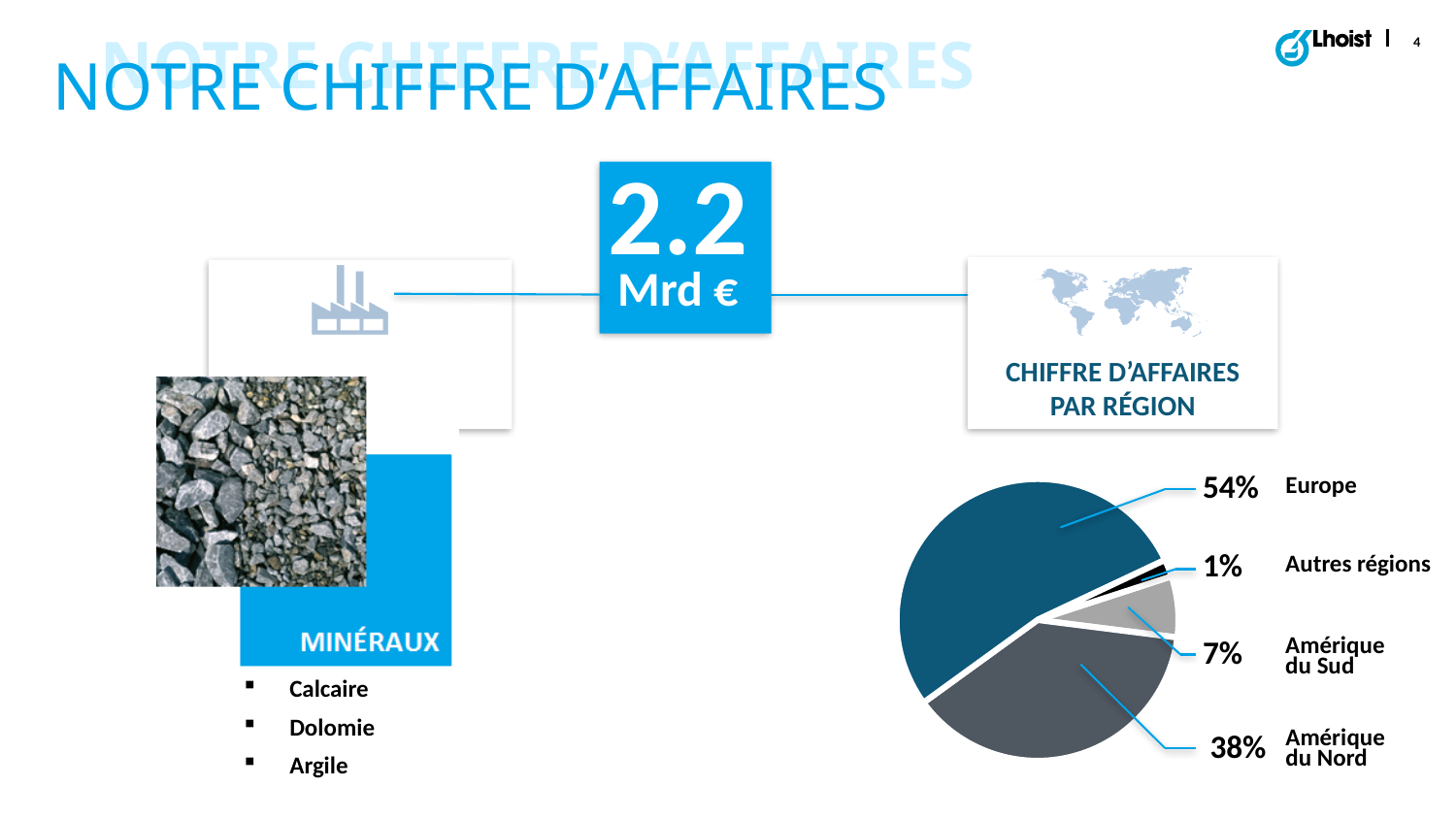
What is the difference in percentage points between Europe and Amérique du Nord in the pie chart? 16 What share of revenue does Amérique du Nord account for in the pie chart? 38% What is the title shown above the pie chart? CHIFFRE D'AFFAIRES PAR RÉGION Which is larger in the pie chart, Amérique du Sud or Autres régions? Amérique du Sud Which region has the largest slice of the pie chart? Europe How many regions are shown in the pie chart? 4 What share of revenue does Autres régions account for in the pie chart? 1% What share of revenue does Europe account for in the pie chart? 54% What kind of chart is shown on the slide? pie chart What share of revenue does Amérique du Sud account for in the pie chart? 7% What is the combined share of Amérique du Nord and Amérique du Sud in the pie chart? 45% Which region has the smallest slice of the pie chart? Autres régions